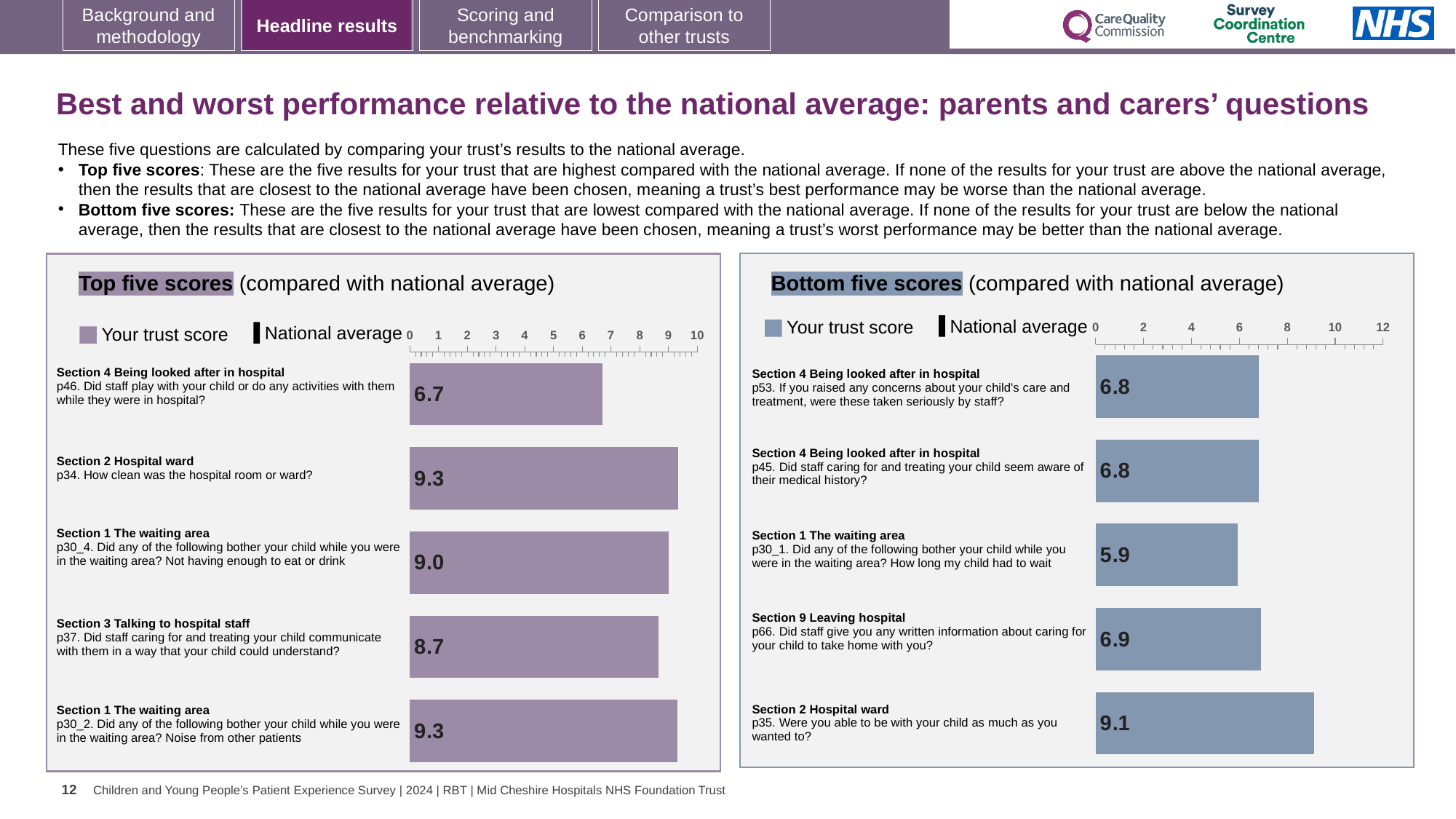
In the Bottom five scores chart, what is the difference between the trust scores for p35 and p30_1? 3.2 In the Bottom five scores chart, what is the trust score for p30_1 (How long my child had to wait)? 5.9 In the Bottom five scores chart, what is the trust score for p35 (Were you able to be with your child as much as you wanted to?)? 9.1 In the Top five scores chart, what is the trust score for p46 (Did staff play with your child or do any activities with them while they were in hospital?)? 6.7 In the Top five scores chart, what is the trust score for p34 (How clean was the hospital room or ward?)? 9.3 In the Bottom five scores chart, which has the larger trust score: p66 or p53? p66 In the Top five scores chart, which question has the lowest trust score? p46. Did staff play with your child or do any activities with them while they were in hospital? In the Bottom five scores chart, which question has the highest trust score? p35. Were you able to be with your child as much as you wanted to? In the Top five scores chart, what is the difference between the trust scores for p30_4 and p37? 0.3 In the Bottom five scores chart, which question has the lowest trust score? p30_1. Did any of the following bother your child while you were in the waiting area? How long my child had to wait What type of chart is the Bottom five scores chart? Bar chart How many questions are shown in the Top five scores chart? 5